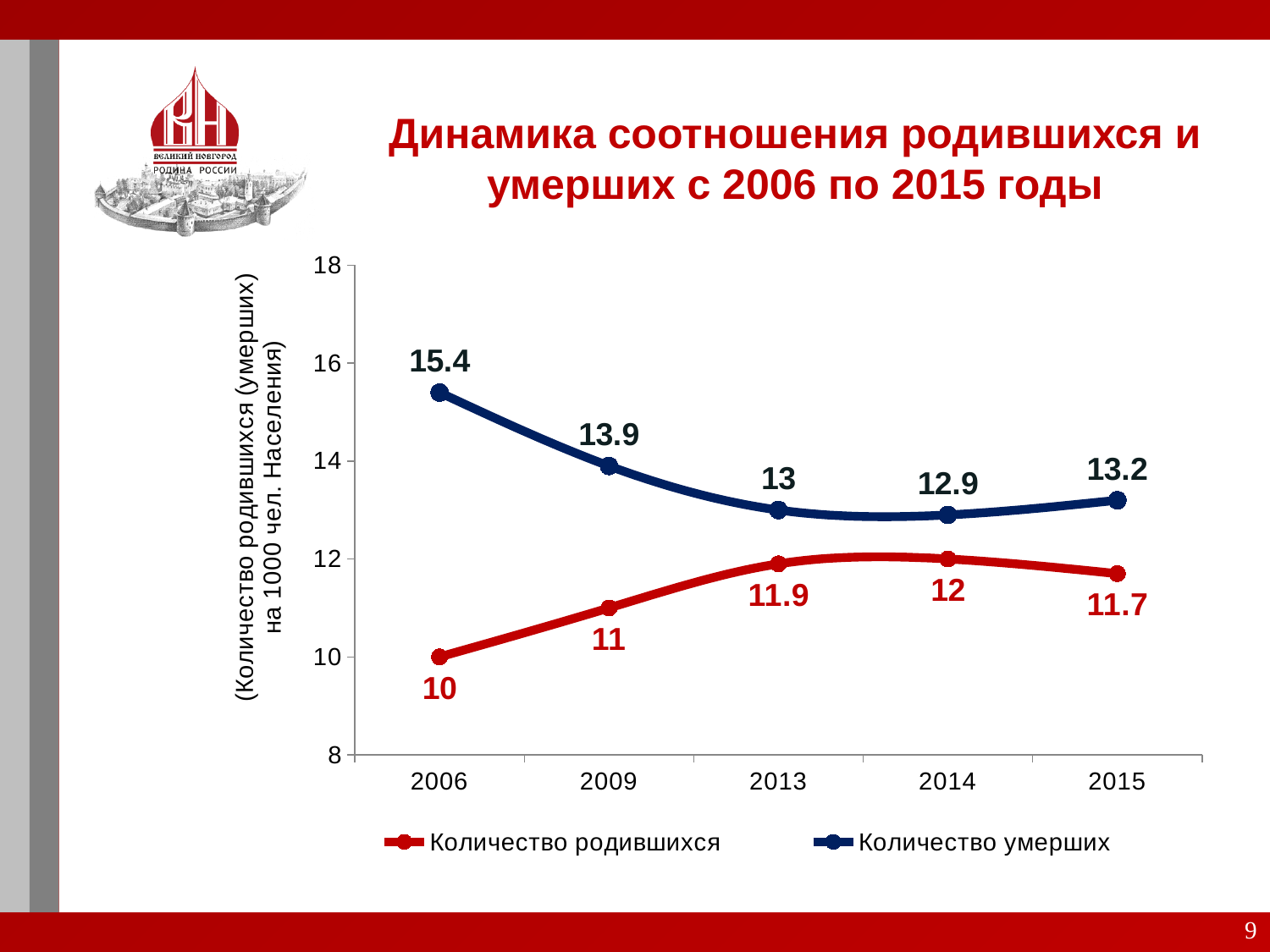
In which year is Количество родившихся lowest? 2006 Which is larger in 2013, Количество родившихся or Количество умерших? Количество умерших What is the value for Количество родившихся in 2006? 10 What is the difference between Количество умерших and Количество родившихся in 2014? 0.9 How many years are shown on the x axis? 5 How many series does the legend list? 2 What is the value for Количество родившихся in 2015? 11.7 In which year is Количество умерших highest? 2006 What is the difference between Количество умерших and Количество родившихся in 2006? 5.4 What kind of chart is shown on the slide? line chart Does Количество умерших rise or fall from 2006 to 2013? fall What is the value for Количество умерших in 2009? 13.9